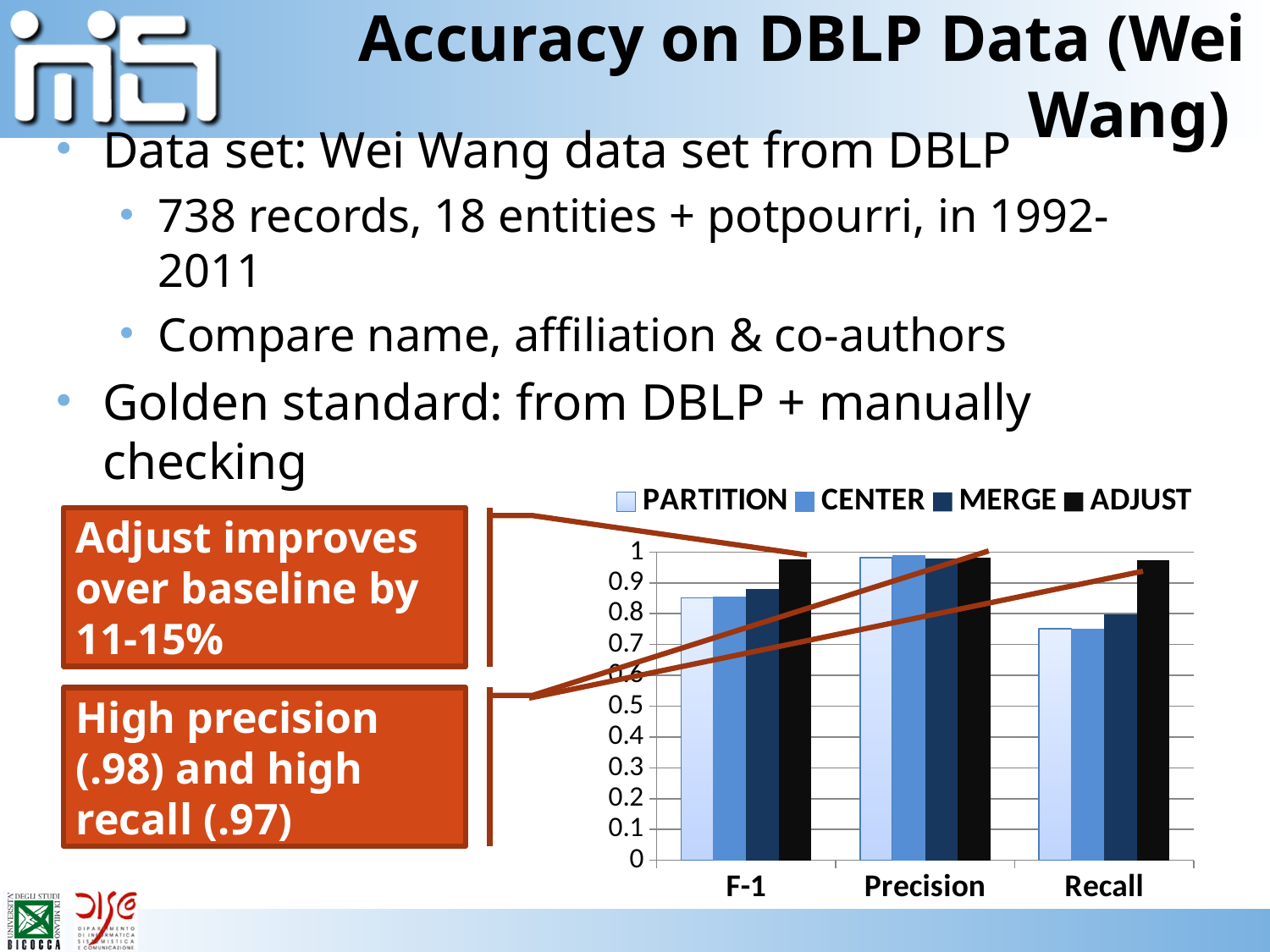
How many series does the chart legend list? 4 For Recall, which series has the highest bar? ADJUST For the PARTITION series, which category has the lowest value? Recall What are the three categories on the x axis of the chart? F-1, Precision, Recall Is the ADJUST value for F-1 greater or less than 0.9? greater Is the ADJUST value for Recall greater or less than 0.9? greater Is the PARTITION value for F-1 greater or less than 0.8? greater How many categories are shown on the x axis of the chart? 3 Which series is drawn in black in the chart? ADJUST What kind of chart is shown on the slide? bar chart For F-1, which is larger: the ADJUST bar or the MERGE bar? ADJUST